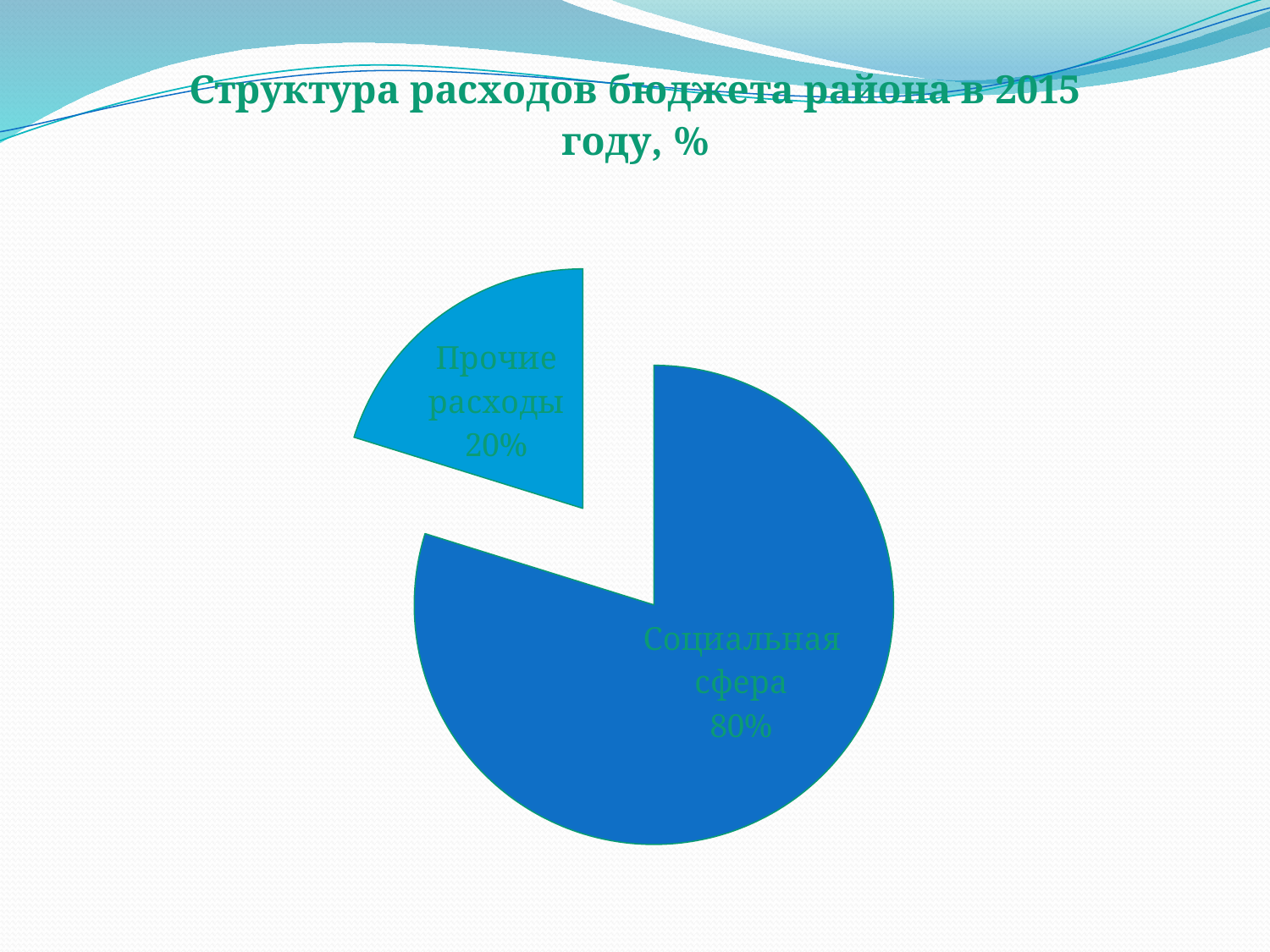
What share of the pie does "Социальная сфера" take? 80% Which is larger, "Социальная сфера" or "Прочие расходы"? Социальная сфера What share of the pie does "Прочие расходы" take? 20% Which slice of the pie is the largest? Социальная сфера Which slice of the pie is the smallest? Прочие расходы Which slice is pulled out (exploded) from the pie? Прочие расходы What is the title of the chart on the slide? Структура расходов бюджета района в 2015 году, % How many slices does the pie chart have? 2 What is the difference in percentage points between "Социальная сфера" and "Прочие расходы"? 60 What kind of chart is shown on the slide? pie chart